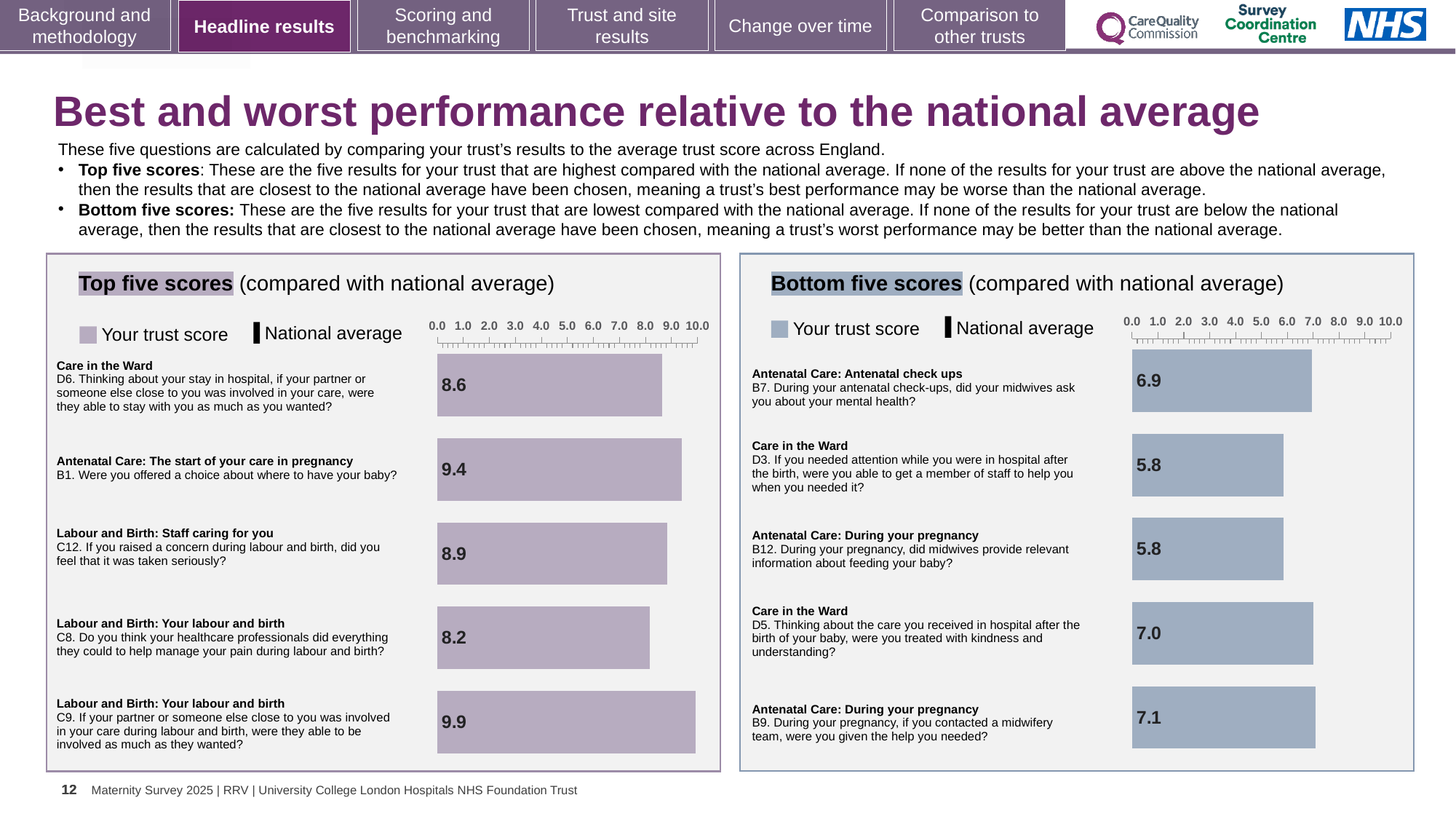
In the Top five scores chart, what is the difference between the highest score (C9) and the lowest score (C8)? 1.7 In the Top five scores chart, which question has the lowest trust score? C8 (Labour and Birth: Your labour and birth) In the Bottom five scores chart, which question has the highest trust score? B9 (Antenatal Care: During your pregnancy) How many questions are shown in the Bottom five scores chart? 5 In the Bottom five scores chart, what is the trust score for question B7 (midwives asking about mental health at antenatal check-ups)? 6.9 In the Top five scores chart, which has the higher trust score: B1 or C12? B1 In the Top five scores chart, what is the trust score for question C9 (partner involved as much as they wanted during labour and birth)? 9.9 In the Top five scores chart, which question has the highest trust score? C9 (Labour and Birth: Your labour and birth) In the Bottom five scores chart, what is the difference between the score for B9 and the score for D3? 1.3 In the Bottom five scores chart, is the trust score for D5 greater or less than 6.0? greater What type of chart is used for the Top five scores? Bar chart How many series does the legend of the Top five scores chart list? 2